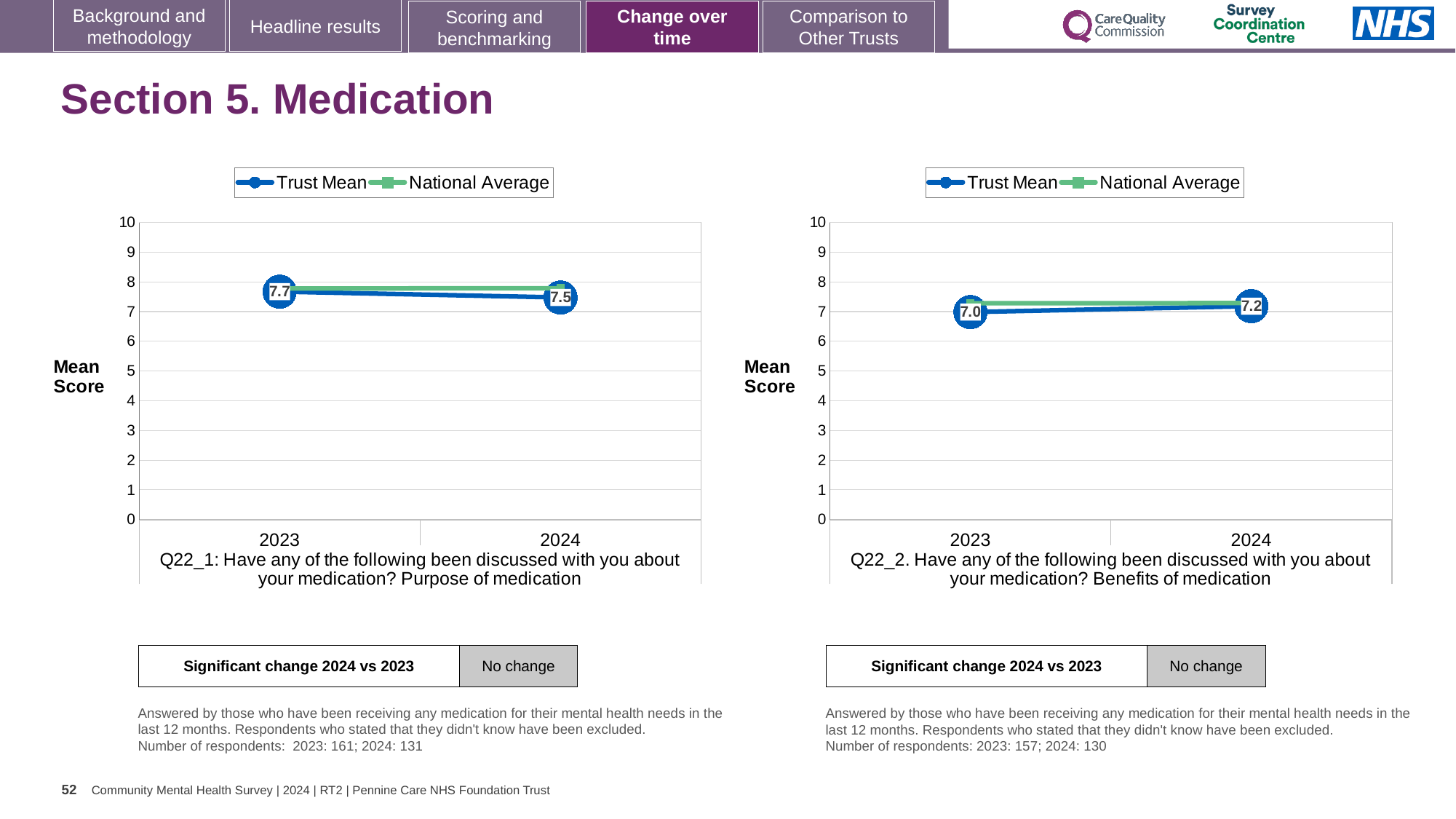
In the Q22_1 chart (Purpose of medication), does the Trust Mean rise or fall from 2023 to 2024? fall In the Q22_1 chart (Purpose of medication), what is the Trust Mean score for 2023? 7.7 In the Q22_2 chart (Benefits of medication), is the Trust Mean for 2023 greater or less than 8? less How many years are plotted on the x axis of the Q22_1 chart (Purpose of medication)? 2 In the Q22_1 chart (Purpose of medication), what is the Trust Mean score for 2024? 7.5 In the Q22_2 chart (Benefits of medication), what is the Trust Mean score for 2024? 7.2 What kind of chart is the Q22_2 chart (Benefits of medication)? line chart In the Q22_2 chart (Benefits of medication), does the Trust Mean rise or fall from 2023 to 2024? rise In the Q22_1 chart (Purpose of medication), by how much did the Trust Mean change from 2023 to 2024? 0.2 In the Q22_2 chart (Benefits of medication), what is the Trust Mean score for 2023? 7.0 In the Q22_2 chart (Benefits of medication), by how much did the Trust Mean change from 2023 to 2024? 0.2 How many series does the legend of the Q22_1 chart (Purpose of medication) list? 2